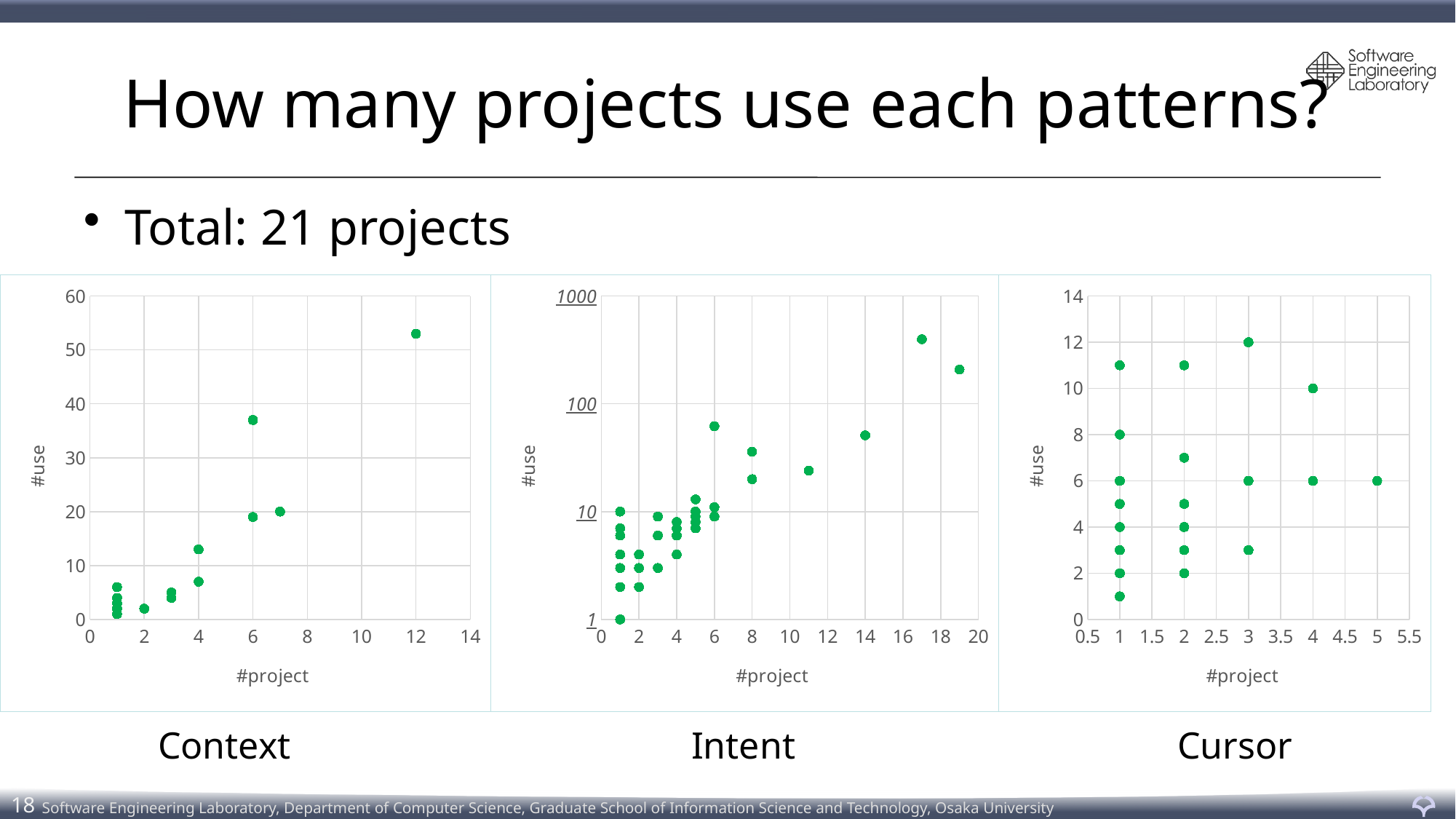
What is the label of the vertical axis on the Cursor chart? #use In the Context chart, what is the largest #project value among the plotted points? 12 In the Cursor chart, what is the largest #use value among the plotted points? 12 In the Context chart, do the #use values generally rise or fall as #project increases? rise What is the label of the horizontal axis on the Intent chart? #project In the Cursor chart, what is the largest #project value among the plotted points? 5 How many charts are shown on the slide? 3 In the Cursor chart, what is the #use value of the point at #project = 5? 6 What kind of chart is the Context chart? scatter chart In the Intent chart, is the #use value of the highest point greater or less than 100? greater In the Intent chart, what is the smallest #use value among the plotted points? 1 In the Context chart, is the #use value of the highest point greater or less than 50? greater